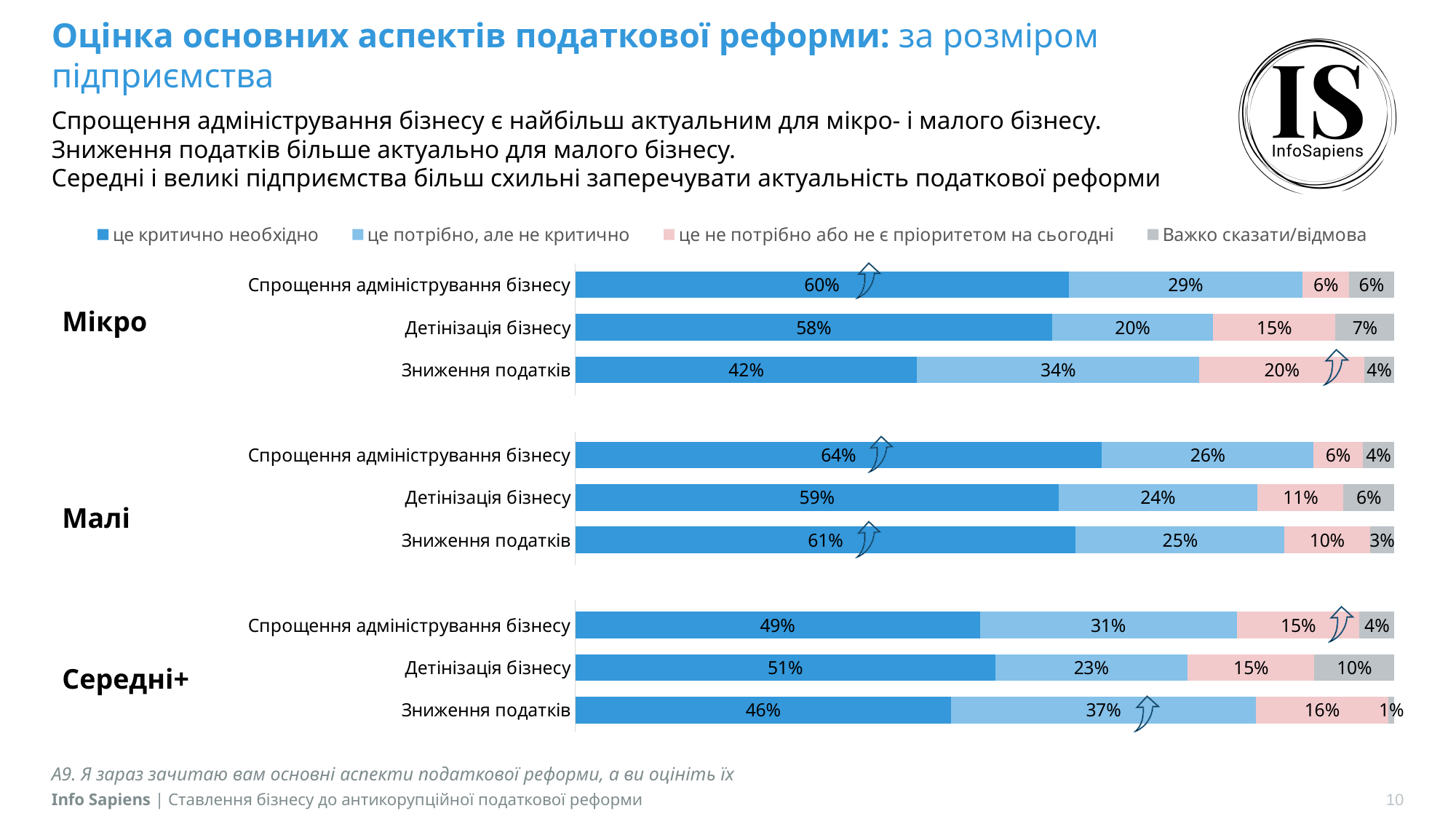
For medium+ enterprises (Середні+), what share say tax reduction (Зниження податків) is needed but not critical (це потрібно, але не критично)? 37% Which colour represents 'це не потрібно або не є пріоритетом на сьогодні' in the chart? Pink (light red) For micro enterprises (Мікро), what share say tax reduction (Зниження податків) is not needed or not a priority (це не потрібно або не є пріоритетом на сьогодні)? 20% For Детінізація бізнесу, which group has a larger 'це потрібно, але не критично' share: Мікро or Середні+? Середні+ What percentage of micro enterprises (Мікро) say simplification of business administration (Спрощення адміністрування бізнесу) is critically necessary (це критично необхідно)? 60% Across all three enterprise sizes, which bar has the lowest share of 'це критично необхідно'? Зниження податків (Мікро) What type of chart is shown on the slide? Stacked bar chart What is the difference in the 'це критично необхідно' share for Спрощення адміністрування бізнесу between small (Малі) and medium+ (Середні+) enterprises? 15 percentage points For medium+ enterprises (Середні+), what share answered 'Важко сказати/відмова' for de-shadowing of business (Детінізація бізнесу)? 10% Among small enterprises (Малі), which aspect has the highest share of 'це критично необхідно'? Спрощення адміністрування бізнесу How many enterprise size groups are shown in the chart? 3 How many series does the legend list? 4